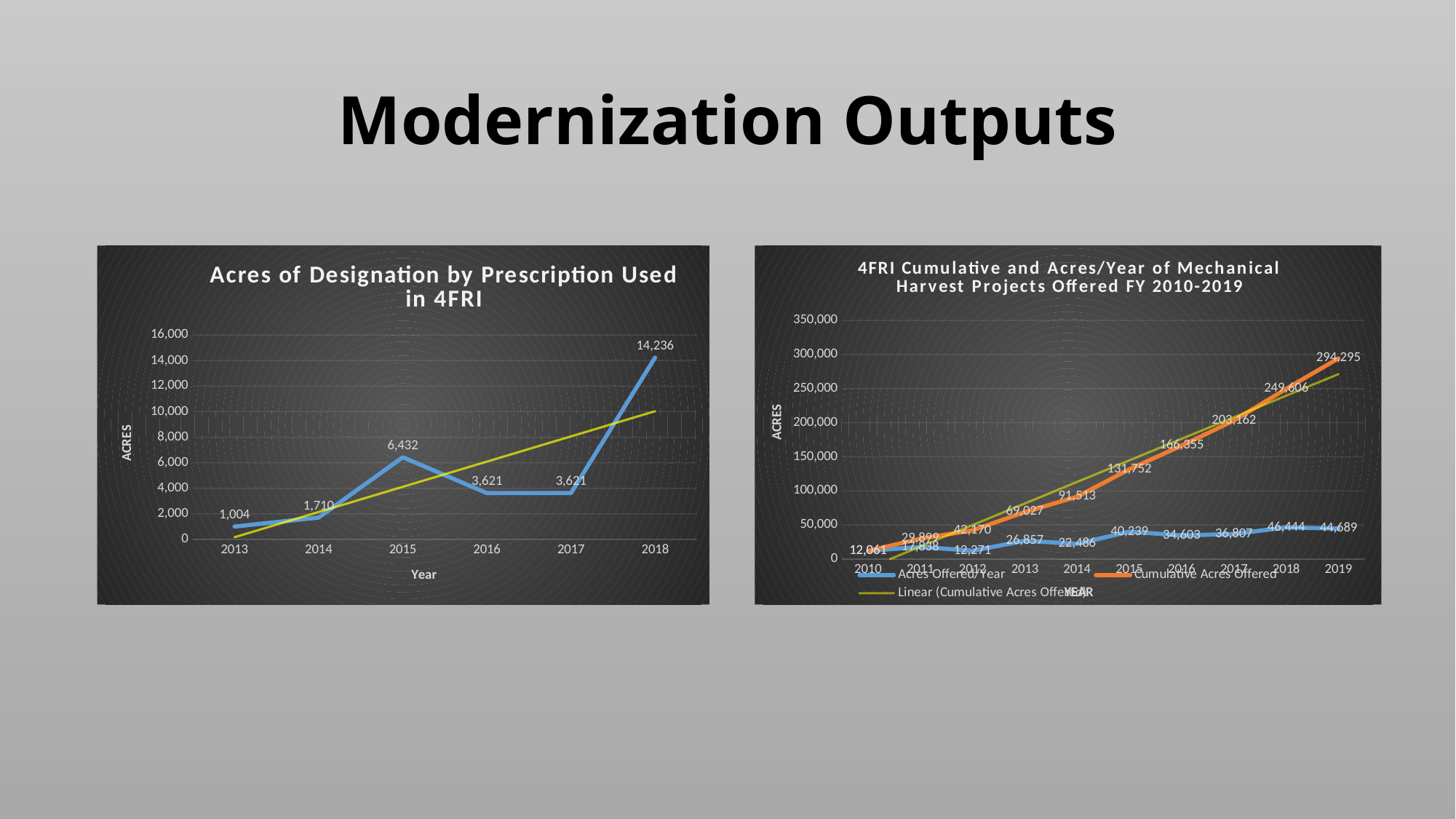
What kind of chart is the left chart, 'Acres of Designation by Prescription Used in 4FRI'? Line chart In the right chart, '4FRI Cumulative and Acres/Year of Mechanical Harvest Projects Offered FY 2010-2019', what is the Acres Offered/Year value for 2015? 40,239 In the left chart, 'Acres of Designation by Prescription Used in 4FRI', which year has the lowest value? 2013 In the right chart, '4FRI Cumulative and Acres/Year of Mechanical Harvest Projects Offered FY 2010-2019', which year has the larger Acres Offered/Year value, 2018 or 2019? 2018 In the left chart, 'Acres of Designation by Prescription Used in 4FRI', what is the difference between the 2018 value and the 2015 value? 7,804 In the right chart, '4FRI Cumulative and Acres/Year of Mechanical Harvest Projects Offered FY 2010-2019', what is the difference between the Cumulative Acres Offered values for 2019 and 2018? 44,689 In the left chart, 'Acres of Designation by Prescription Used in 4FRI', what is the value for 2018? 14,236 In the right chart, '4FRI Cumulative and Acres/Year of Mechanical Harvest Projects Offered FY 2010-2019', what is the Cumulative Acres Offered value for 2019? 294,295 In the right chart, '4FRI Cumulative and Acres/Year of Mechanical Harvest Projects Offered FY 2010-2019', does the Cumulative Acres Offered series rise or fall from 2010 to 2019? Rise How many series does the legend of the right chart, '4FRI Cumulative and Acres/Year of Mechanical Harvest Projects Offered FY 2010-2019', list? 3 In the left chart, 'Acres of Designation by Prescription Used in 4FRI', which year has the highest value? 2018 In the left chart, 'Acres of Designation by Prescription Used in 4FRI', how many years are plotted on the x axis? 6